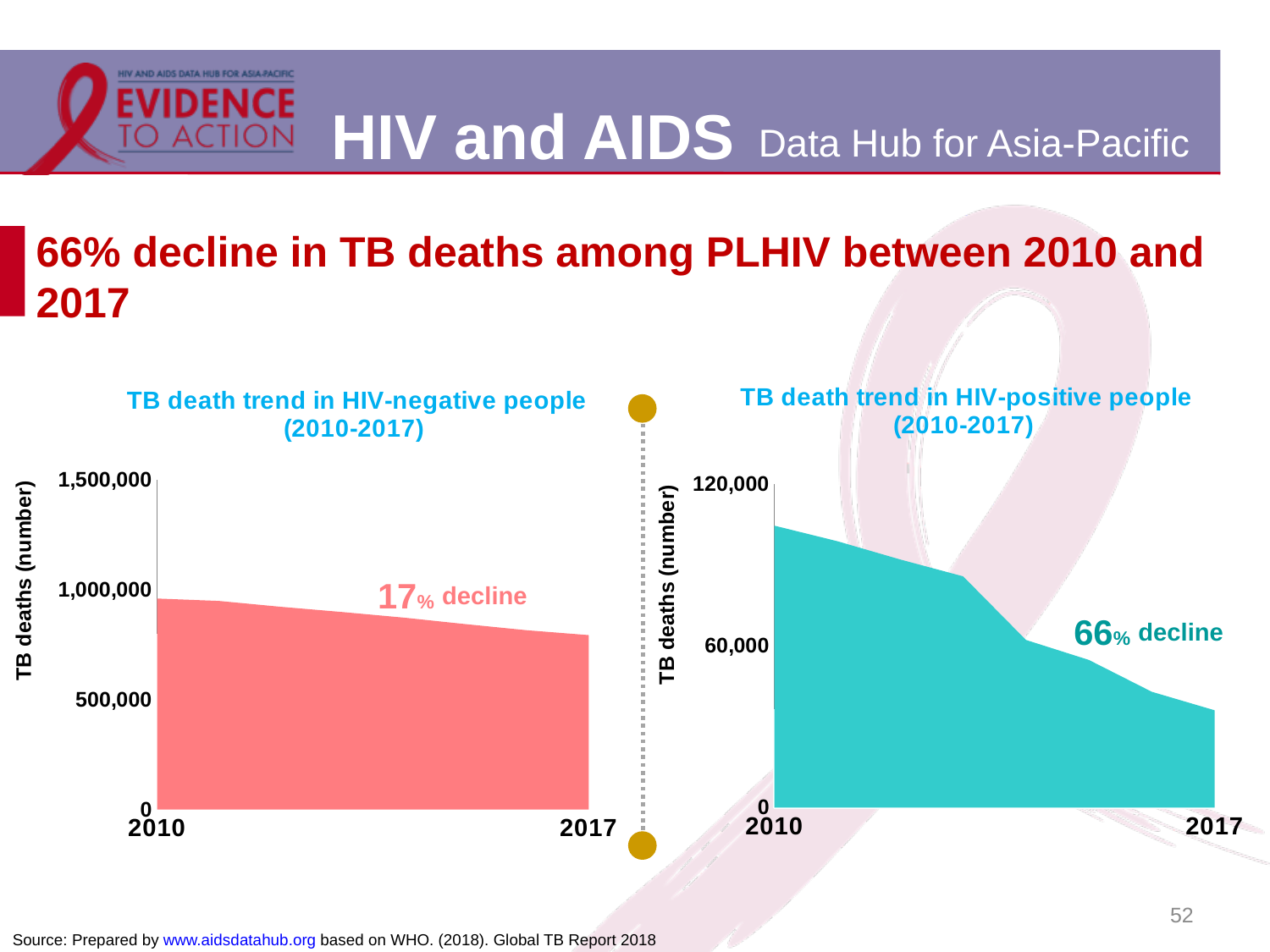
In the 'TB death trend in HIV-negative people (2010-2017)' chart, is the value for 2010 greater or less than 1,000,000? less In the 'TB death trend in HIV-negative people (2010-2017)' chart, do TB deaths rise or fall from 2010 to 2017? fall What is the highest y-axis tick shown on the 'TB death trend in HIV-positive people (2010-2017)' chart? 120,000 What is the y-axis label on the 'TB death trend in HIV-negative people (2010-2017)' chart? TB deaths (number) In the 'TB death trend in HIV-positive people (2010-2017)' chart, is the value for 2017 greater or less than 60,000? less What percentage decline is annotated on the 'TB death trend in HIV-negative people (2010-2017)' chart? 17% decline In the 'TB death trend in HIV-positive people (2010-2017)' chart, which year has the higher value, 2010 or 2017? 2010 What percentage decline is annotated on the 'TB death trend in HIV-positive people (2010-2017)' chart? 66% decline In the 'TB death trend in HIV-negative people (2010-2017)' chart, is the value for 2017 greater or less than 500,000? greater In the 'TB death trend in HIV-positive people (2010-2017)' chart, do TB deaths rise or fall from 2010 to 2017? fall What kind of chart is the 'TB death trend in HIV-negative people (2010-2017)' chart? area chart